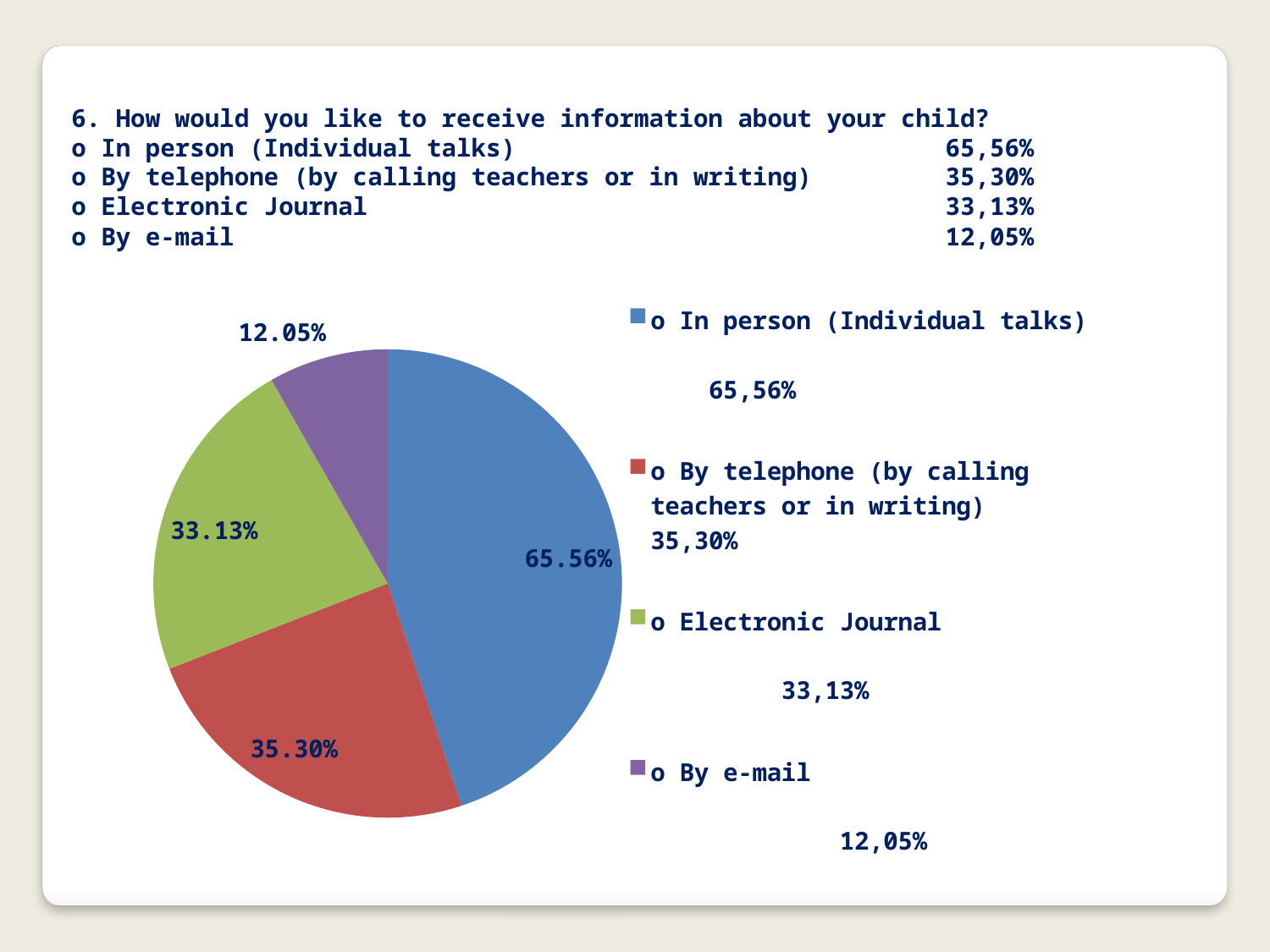
Which category has the smallest slice of the pie chart? By e-mail What colour is the 'Electronic Journal' slice in the pie chart? green What kind of chart is shown on the slide? pie chart How many entries does the legend of the pie chart list? 4 What is the data label for the 'By e-mail' slice? 12.05% What is the data label for the 'Electronic Journal' slice? 33.13% Which is larger, the 'By telephone' slice or the 'By e-mail' slice? By telephone What is the difference between the data labels for 'In person (Individual talks)' and 'By e-mail'? 53.51% Which category has the largest slice of the pie chart? In person (Individual talks) What is the data label for the 'In person (Individual talks)' slice of the pie chart? 65.56% What is the data label for the 'By telephone (by calling teachers or in writing)' slice? 35.30% How many slices does the pie chart have? 4